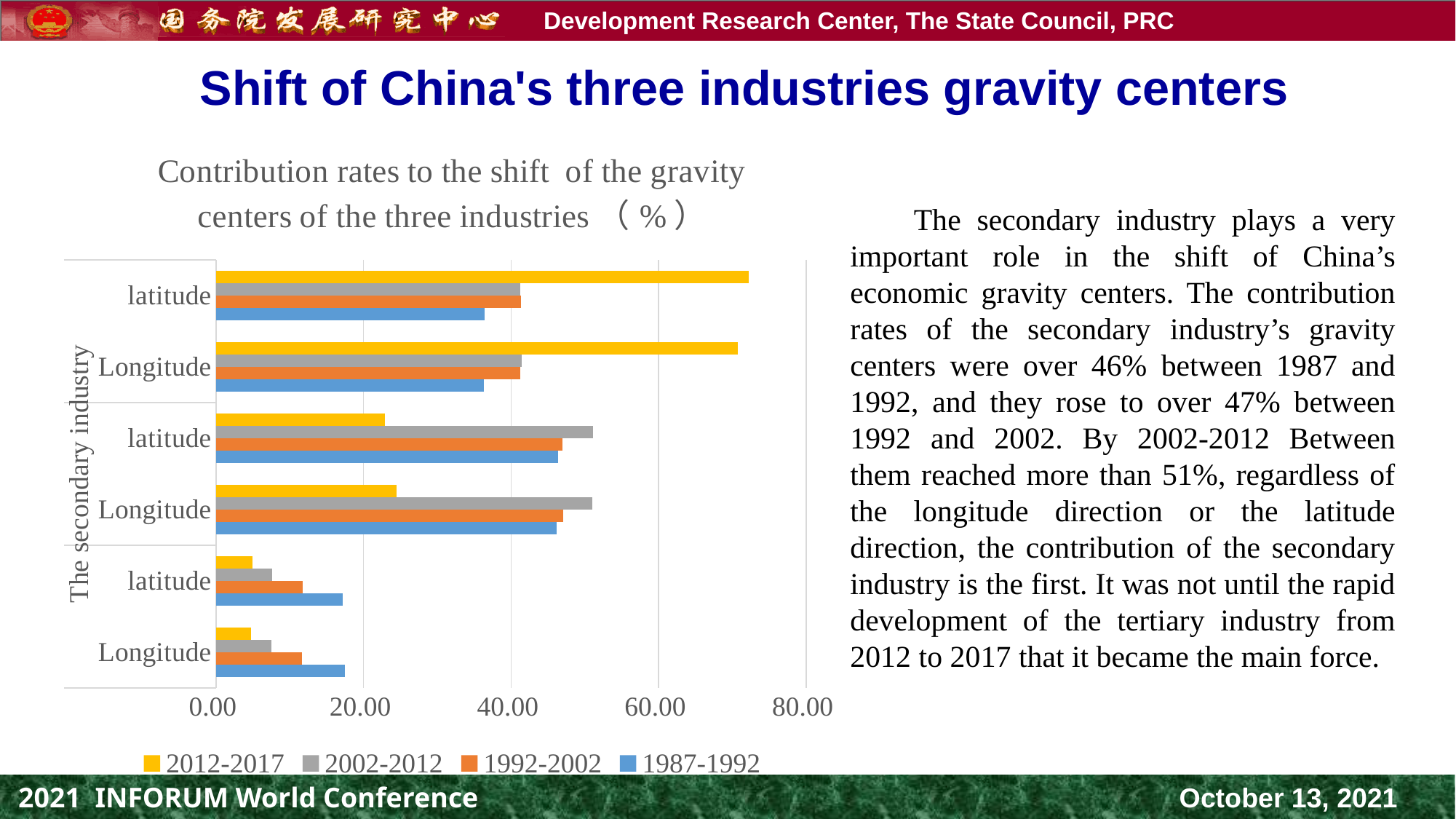
How many category bars groups (latitude/Longitude rows) are plotted on the chart? 6 In the middle 'Longitude' row (fourth from top), which is larger: the 2002-2012 value or the 2012-2017 value? 2002-2012 For the bottom 'Longitude' row, is the 1987-1992 value greater or less than 20.00? less For the topmost 'latitude' row, is the 1987-1992 value greater or less than 40.00? less In the bottom 'Longitude' row, which series has the shortest bar? 2012-2017 How many series does the chart legend list? 4 For the middle 'latitude' row (third from top), is the 2002-2012 value greater or less than 40.00? greater Which series is shown in yellow in the chart legend? 2012-2017 What kind of chart is shown on the slide? bar chart What is the title of the chart? Contribution rates to the shift of the gravity centers of the three industries (%) In the topmost 'latitude' row, which series has the longest bar? 2012-2017